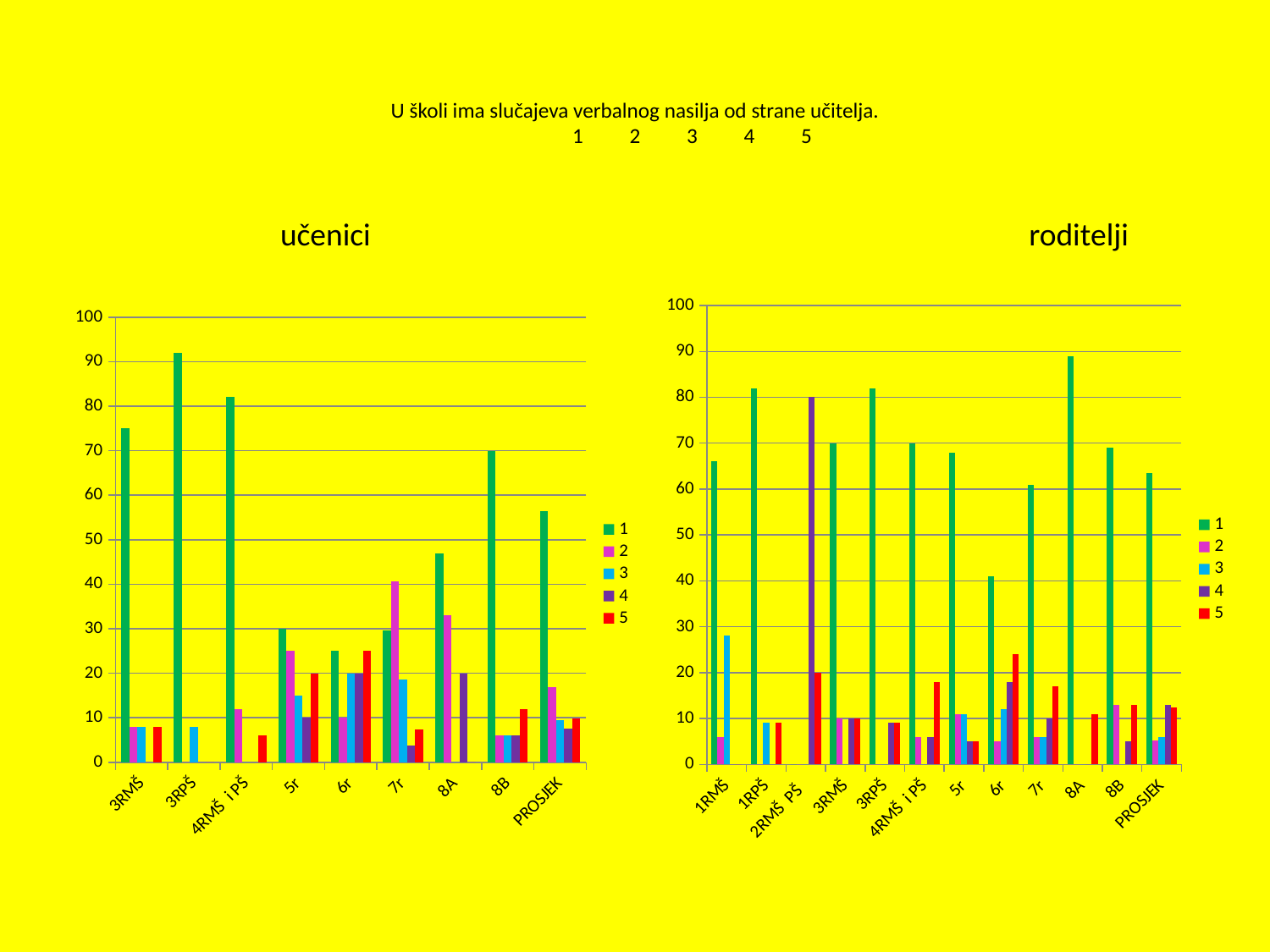
In the "roditelji" chart, which is larger for series 1: 1RPŠ or 5r? 1RPŠ What kind of chart is the "učenici" chart on the left? bar chart In the "roditelji" chart, is the value of series 3 for 1RMŠ greater or less than 20? greater In the "učenici" chart, is the value of series 1 for 8A greater or less than 40? greater In the "učenici" chart, which is larger for series 1: 3RPŠ or 4RMŠ i PŠ? 3RPŠ In the "učenici" chart, is the value of series 1 for 3RMŠ greater or less than 70? greater In the "roditelji" chart, which category has the highest value for series 4? 2RMŠ PŠ In the "učenici" chart, which category has the highest value for series 1? 3RPŠ How many categories are shown on the x axis of the "učenici" chart? 9 How many series does the legend of the "roditelji" chart list? 5 How many categories are shown on the x axis of the "roditelji" chart? 12 In the "roditelji" chart, which category has the highest value for series 1? 8A